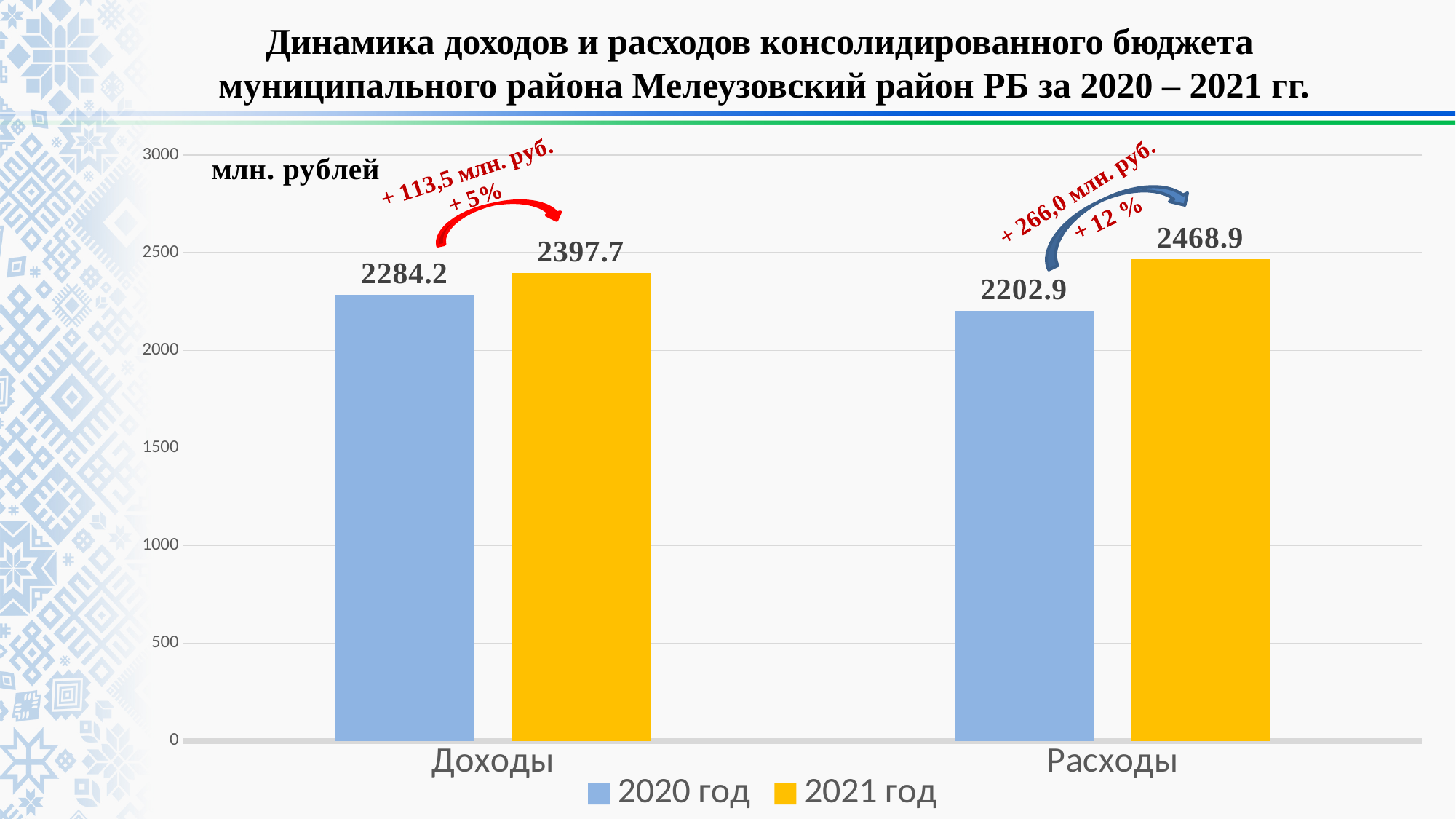
Which bar has the lowest value on the chart? Расходы, 2020 год What kind of chart is shown on the slide? Bar chart Which is larger: Доходы in 2020 год or Расходы in 2020 год? Доходы in 2020 год What is the value for Доходы in 2021 год? 2397.7 What is the difference between Расходы in 2021 год and Расходы in 2020 год? 266.0 What is the value for Расходы in 2021 год? 2468.9 How many series does the legend list? 2 What unit is indicated at the top left of the chart? млн. рублей Which bar has the highest value on the chart? Расходы, 2021 год What is the value for Расходы in 2020 год? 2202.9 What is the difference between Доходы in 2021 год and Доходы in 2020 год? 113.5 What is the value for Доходы in 2020 год? 2284.2